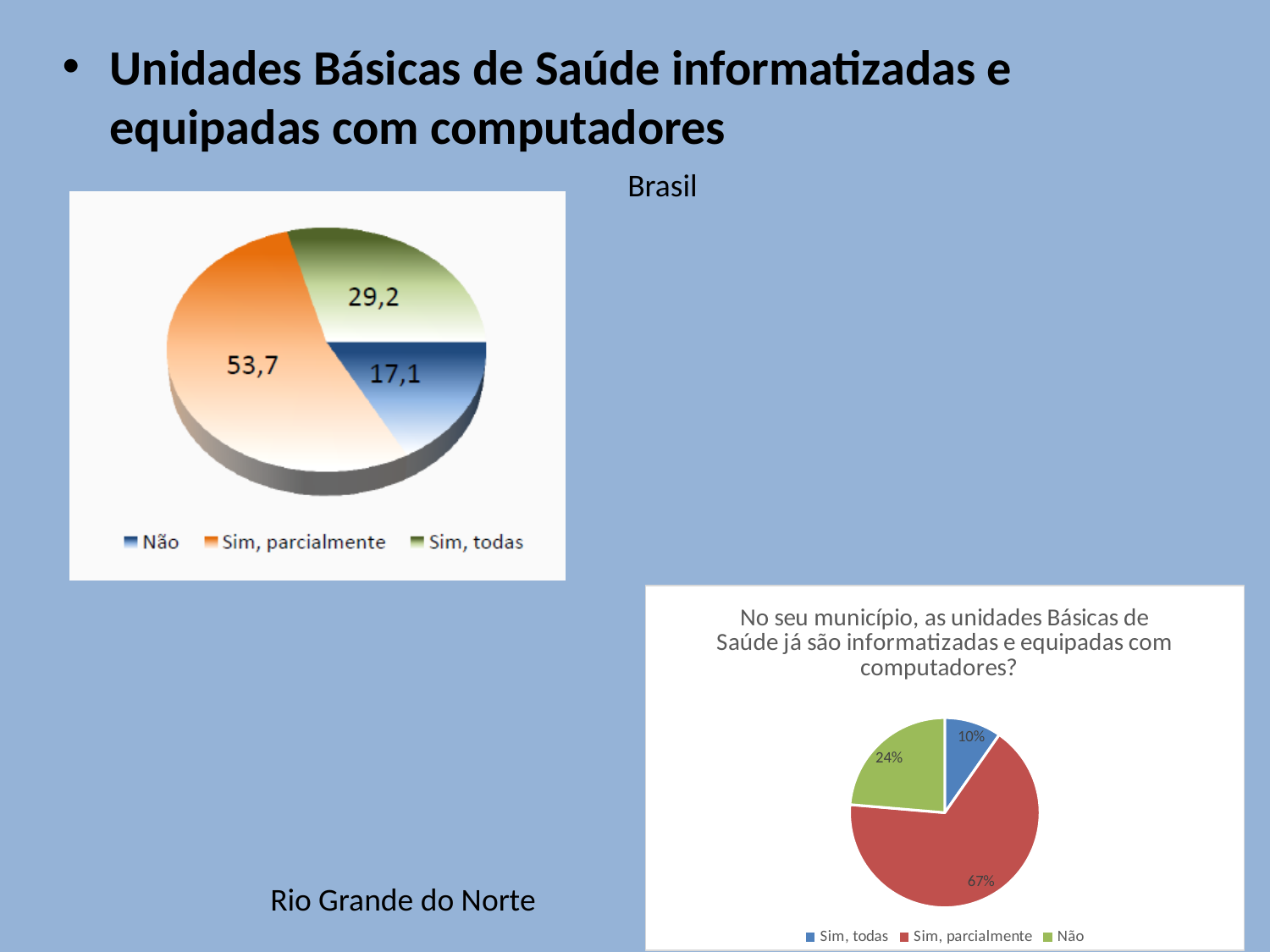
What type of chart is the Rio Grande do Norte chart? Pie chart In the Brasil pie chart, what is the value for "Sim, parcialmente"? 53,7 In the Rio Grande do Norte pie chart, what is the value for "Não"? 24% In the Rio Grande do Norte pie chart, which category has the smallest slice? Sim, todas In the Brasil pie chart, what is the value for "Não"? 17,1 In the Brasil pie chart, what is the difference between "Sim, todas" and "Não"? 12,1 In the Rio Grande do Norte pie chart, what is the value for "Sim, parcialmente"? 67% How many categories does the Brasil pie chart show? 3 In the Rio Grande do Norte pie chart, what is the difference between "Sim, parcialmente" and "Não"? 43% In the Rio Grande do Norte pie chart, which is larger: "Não" or "Sim, todas"? Não In the Brasil pie chart, what is the value for "Sim, todas"? 29,2 In the Brasil pie chart, which category has the largest slice? Sim, parcialmente